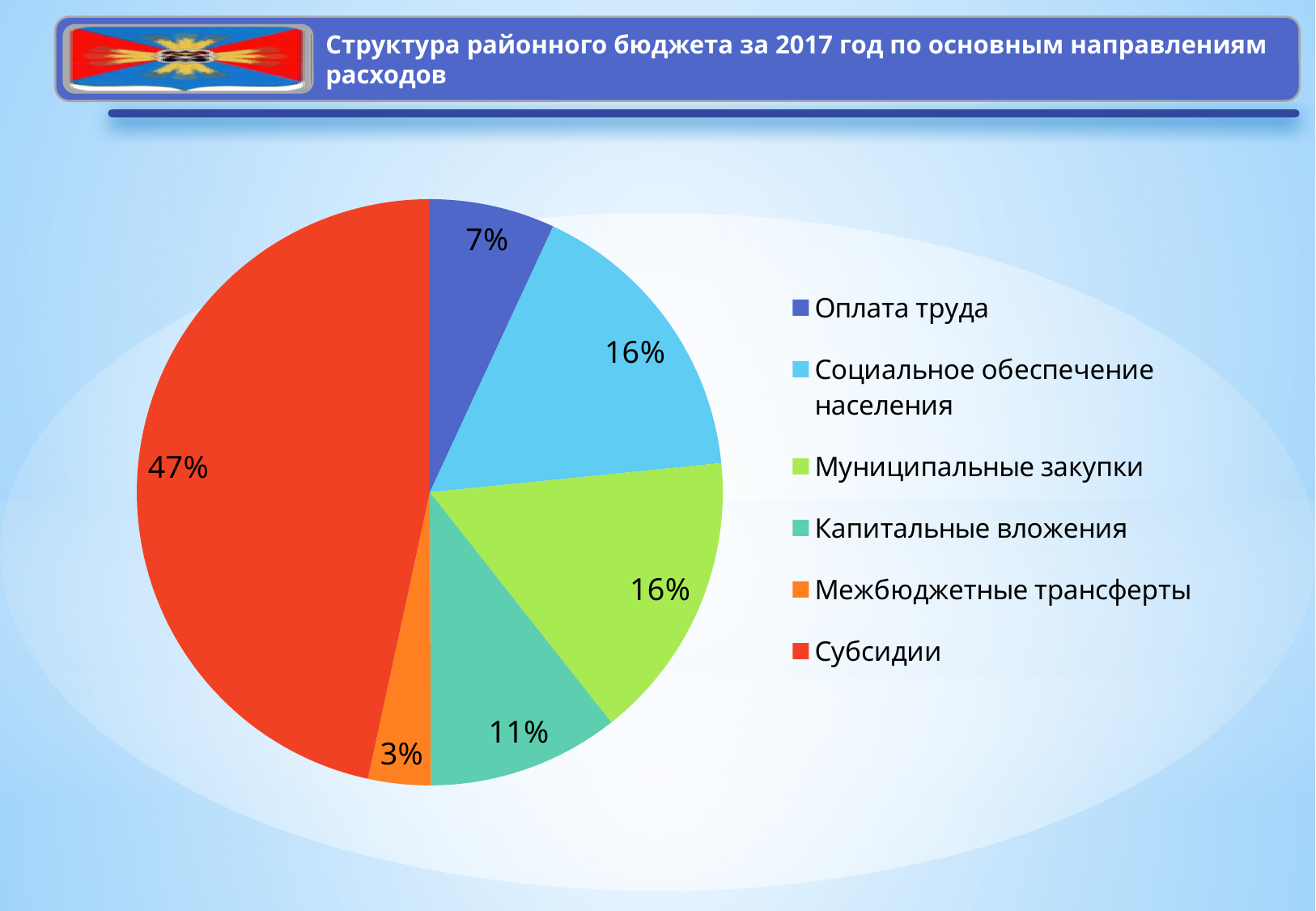
What is the difference between the shares of Субсидии and Капитальные вложения? 36% What is the title of the slide? Структура районного бюджета за 2017 год по основным направлениям расходов Which category has the smallest share of the budget? Межбюджетные трансферты What share of the budget goes to Межбюджетные трансферты? 3% Which is larger, the share of Оплата труда or the share of Капитальные вложения? Капитальные вложения What share of the budget goes to Оплата труда? 7% Which category has the largest share of the budget? Субсидии What share of the budget goes to Муниципальные закупки? 16% How many categories does the legend list? 6 What kind of chart is shown on the slide? pie chart